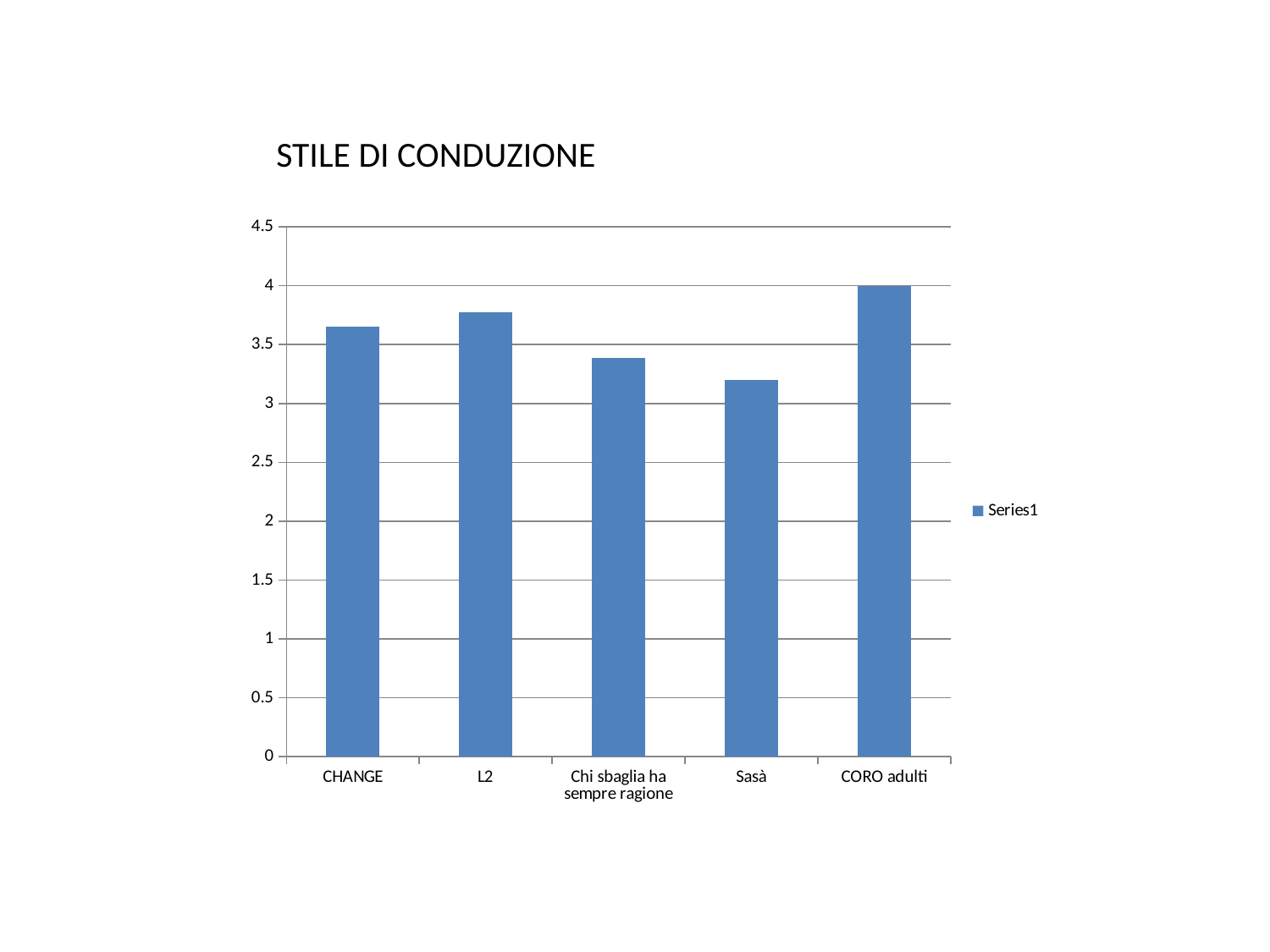
What is the title of the chart? STILE DI CONDUZIONE What is the value for CORO adulti? 4 Is the value for Chi sbaglia ha sempre ragione greater or less than 3.5? less Which category has the lowest value? Sasà How many series does the legend list? 1 Is the value for Sasà greater or less than 3? greater Which is larger, the value for L2 or the value for Sasà? L2 What kind of chart is shown on the slide? bar chart How many categories are shown on the x axis? 5 Which category has the highest value? CORO adulti Is the value for CHANGE greater or less than 3.5? greater Which is larger, the value for CHANGE or the value for Chi sbaglia ha sempre ragione? CHANGE